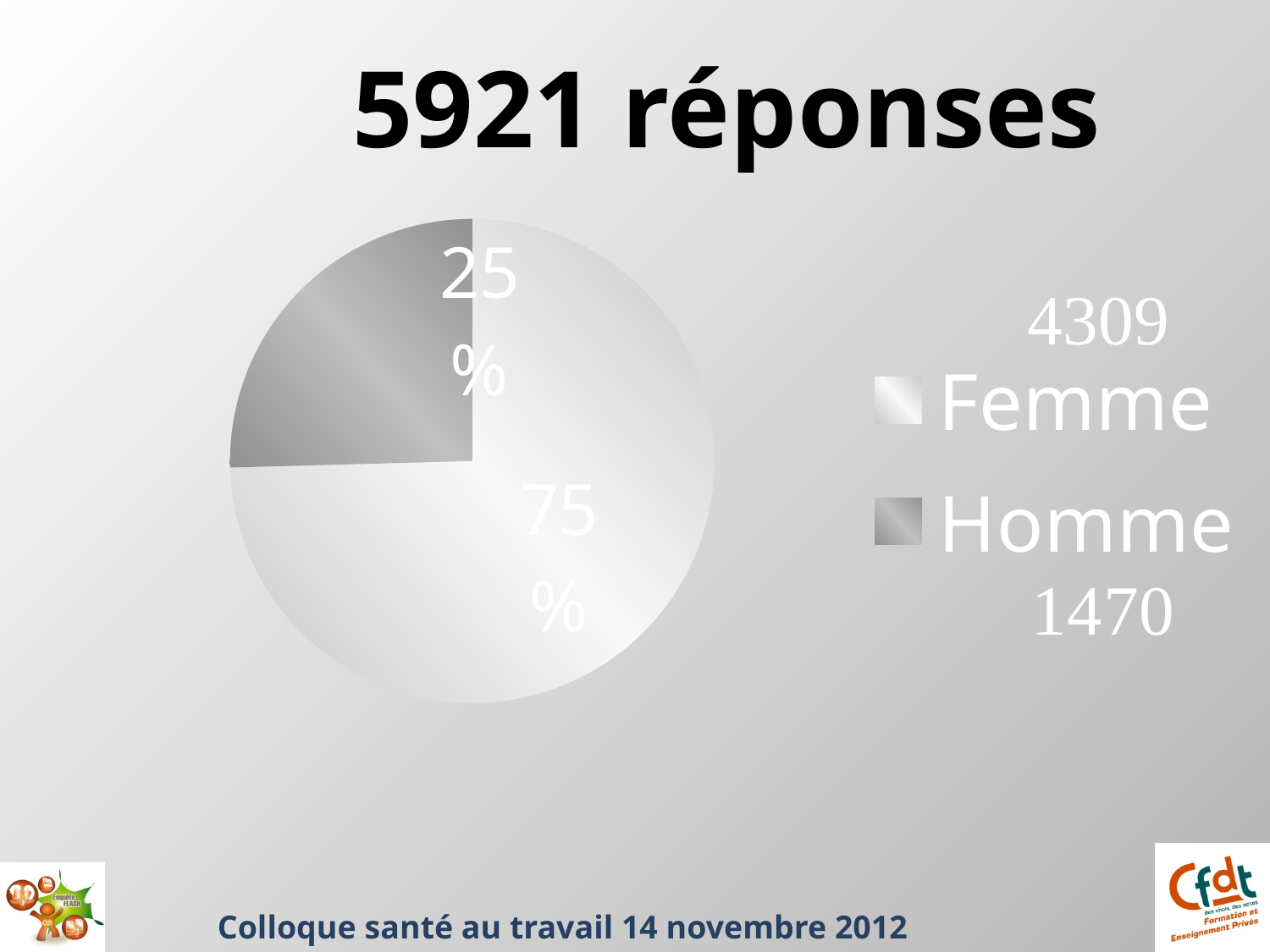
What is the title of the slide above the chart? 5921 réponses Which category has the largest slice of the pie? Femme What kind of chart is shown on the slide? pie chart What is the difference in percentage points between the Femme and Homme slices? 50 What number is shown next to the Homme legend entry? 1470 Which category has the smallest slice of the pie? Homme What number is shown next to the Femme legend entry? 4309 Which slice is larger, Femme or Homme? Femme How many entries does the legend list? 2 What percentage of the pie does the Homme slice represent? 25% What percentage of the pie does the Femme slice represent? 75% How many slices does the pie chart have? 2